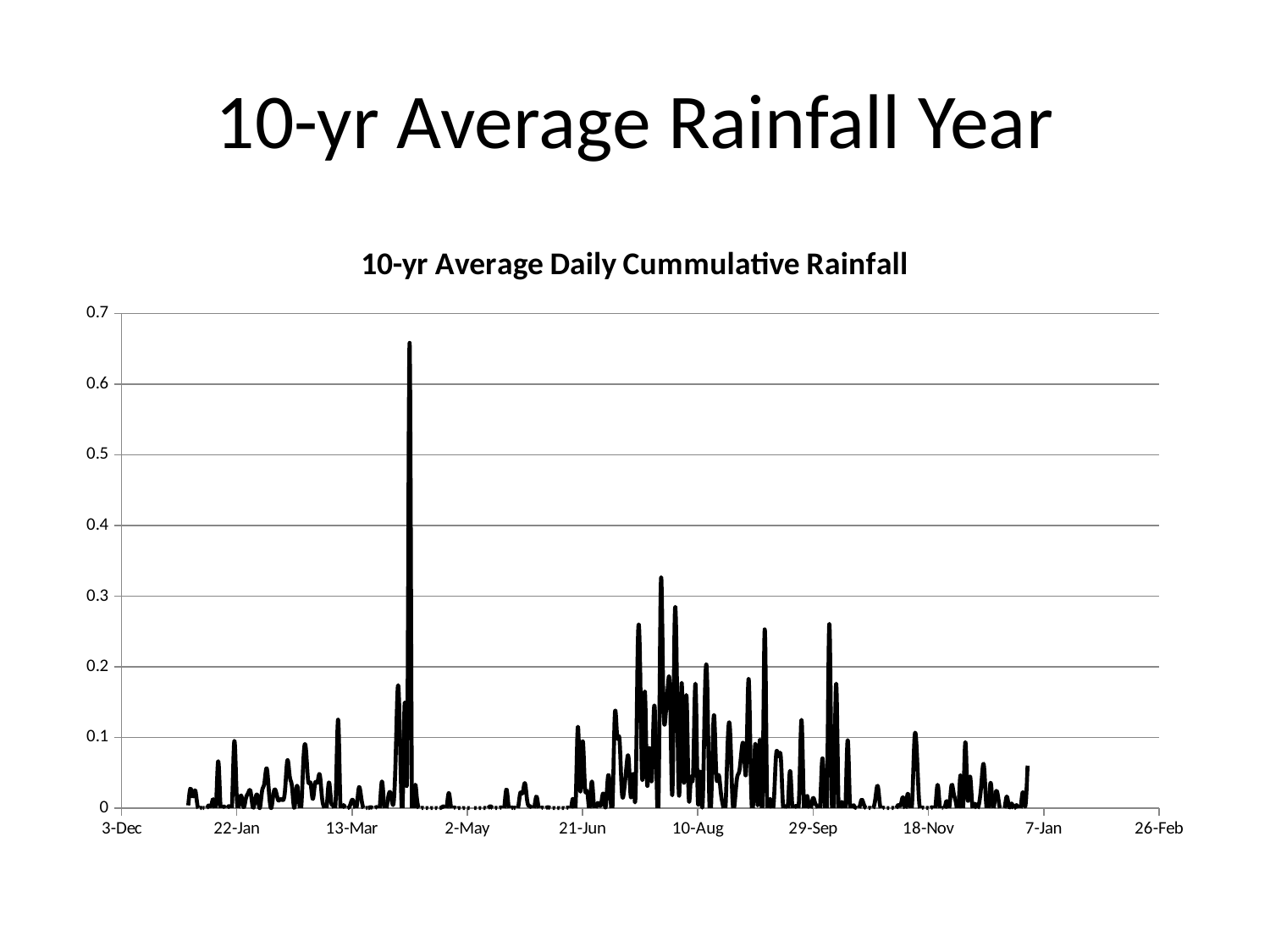
Is the tallest peak just after 29-Sep greater or less than 0.2? greater What kind of chart is shown on the slide? line chart What is the title of the chart? 10-yr Average Daily Cummulative Rainfall How many date labels are shown on the x axis? 10 Is the highest peak of the line greater or less than 0.6? greater Which is larger: the highest peak between 13-Mar and 2-May, or the highest peak between 21-Jun and 10-Aug? the peak between 13-Mar and 2-May Is the highest peak of the line greater or less than 0.7? less Between which two labeled dates on the x axis does the highest peak of the line occur? 13-Mar and 2-May What is the highest value labeled on the y axis? 0.7